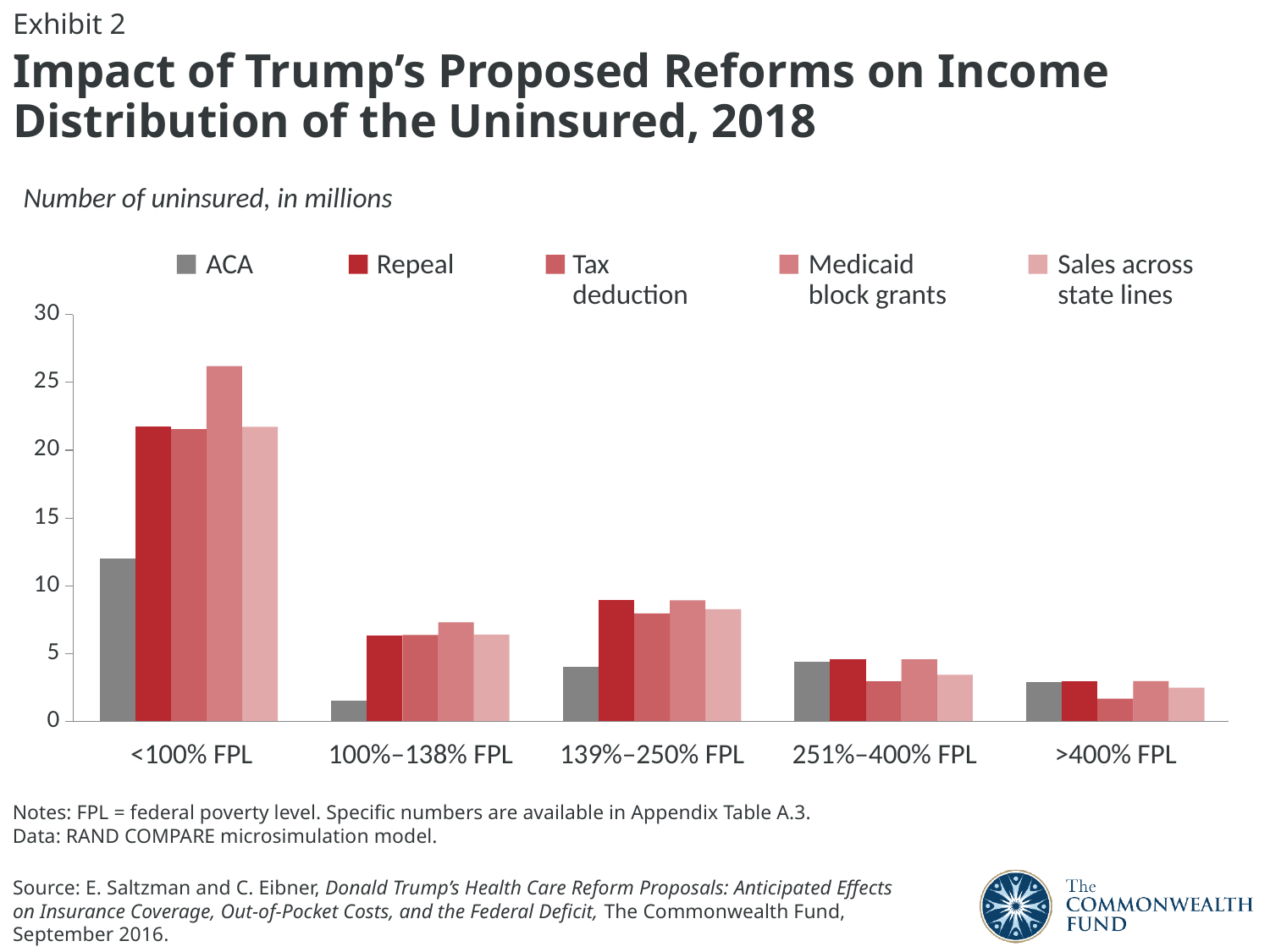
Which series has the lowest bar in the 100%–138% FPL category? ACA Which income category has the highest Medicaid block grants bar? <100% FPL What kind of chart is shown on the slide? bar chart Is the ACA value for <100% FPL greater or less than 10? greater Is the Repeal value for 139%–250% FPL greater or less than 5? greater Is the Medicaid block grants value for <100% FPL greater or less than 25? greater How many series does the legend list? 5 For <100% FPL, which is larger: the Medicaid block grants bar or the Repeal bar? Medicaid block grants How many income categories are shown on the x axis? 5 What unit does the chart's subtitle say the values are in? Number of uninsured, in millions For 139%–250% FPL, which is larger: the ACA bar or the Repeal bar? Repeal